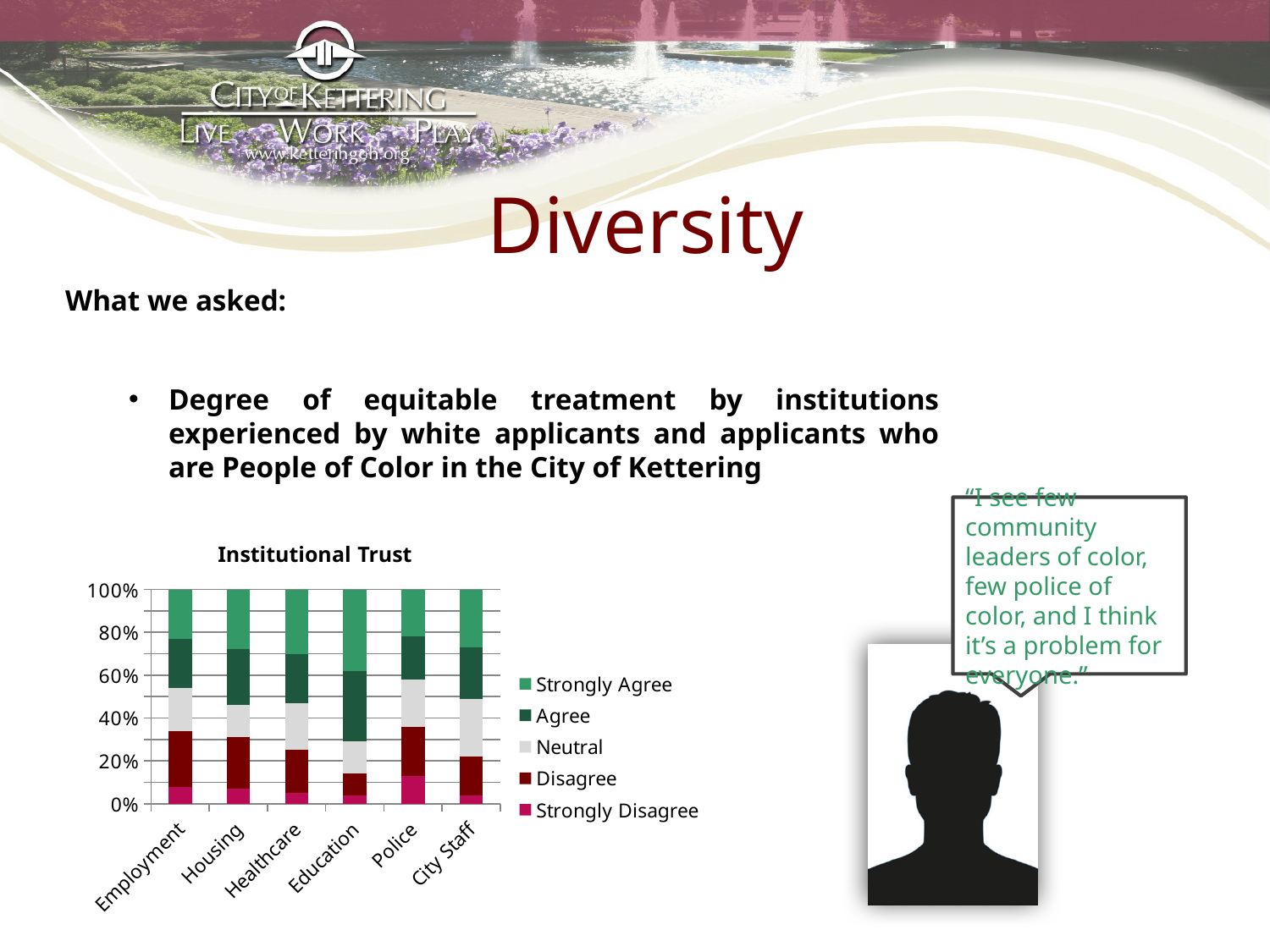
What is the total height of the Employment bar in the Institutional Trust chart? 100% Which legend entry is shown at the bottom of the legend in the Institutional Trust chart? Strongly Disagree What is the title of the chart on the slide? Institutional Trust In the Institutional Trust chart, is the top of the Disagree segment for Education greater or less than 20%? less What type of chart is the Institutional Trust chart? Stacked bar chart Which category has the largest Strongly Agree segment in the Institutional Trust chart? Education In the Institutional Trust chart, is the top of the Disagree segment for Employment greater or less than 20%? greater Which category has the largest Strongly Disagree segment in the Institutional Trust chart? Police How many series does the legend of the Institutional Trust chart list? 5 Which category has the smallest Disagree segment in the Institutional Trust chart? Education How many categories are shown on the x axis of the Institutional Trust chart? 6 In the Institutional Trust chart, is the Strongly Agree segment for Education larger or smaller than the Strongly Agree segment for Housing? larger